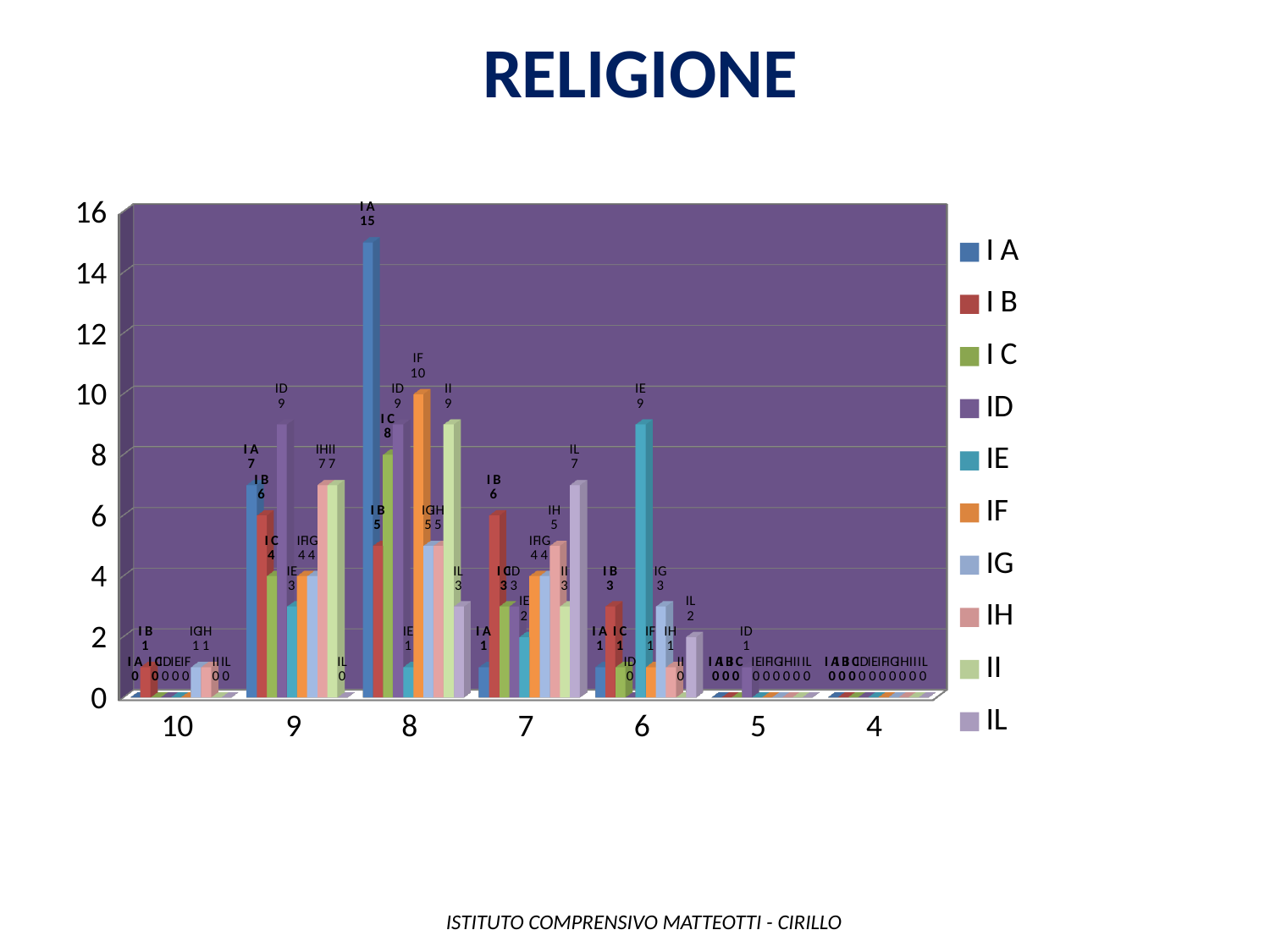
At category 9, which is larger: the value for ID or the value for I A? ID What kind of chart is shown on the slide? bar chart What is the difference between the I A value and the ID value at category 8? 6 What is the value for series IL at category 7? 7 What is the value for series I A at category 8? 15 Is the value for I A at category 8 greater or less than 14? greater What is the value for series IE at category 6? 9 What is the value for series IF at category 8? 10 How many series does the legend list? 10 Which series has the highest value at category 9? ID Which series has the highest value at category 8? I A How many categories are shown on the x axis? 7